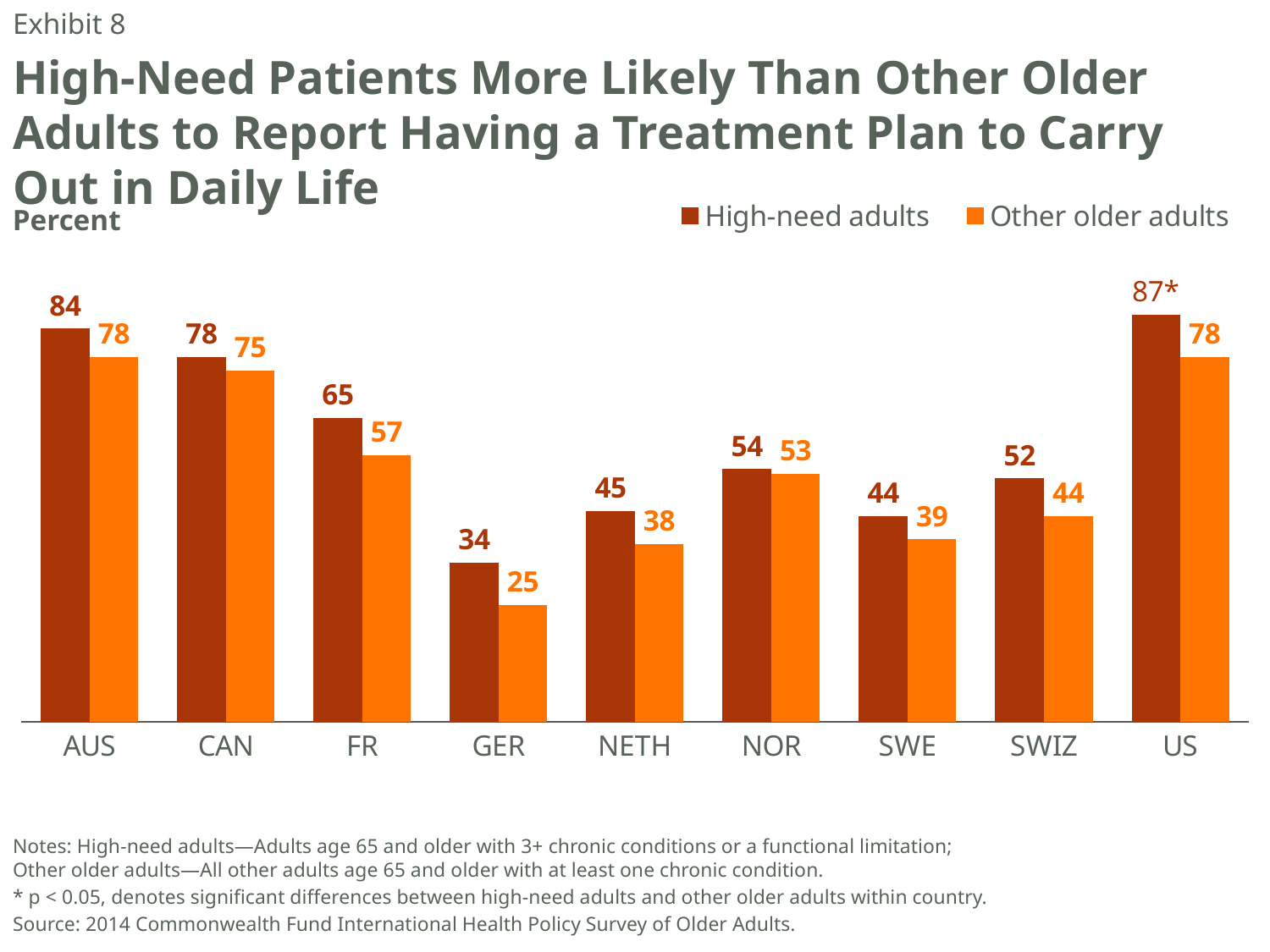
What is the value for High-need adults in the US? 87 What kind of chart is shown on the slide? Bar chart What is the difference between the High-need adults values for AUS and CAN? 6 How many series does the legend list? 2 What is the value for Other older adults in FR? 57 How many countries are shown on the x axis? 9 What unit does the label above the chart say the values are in? Percent What is the value for High-need adults in GER? 34 Which country has the lowest value for Other older adults? GER What is the difference between High-need adults and Other older adults in NETH? 7 Which is larger in SWE: the value for High-need adults or for Other older adults? High-need adults Which country has the highest value for High-need adults? US